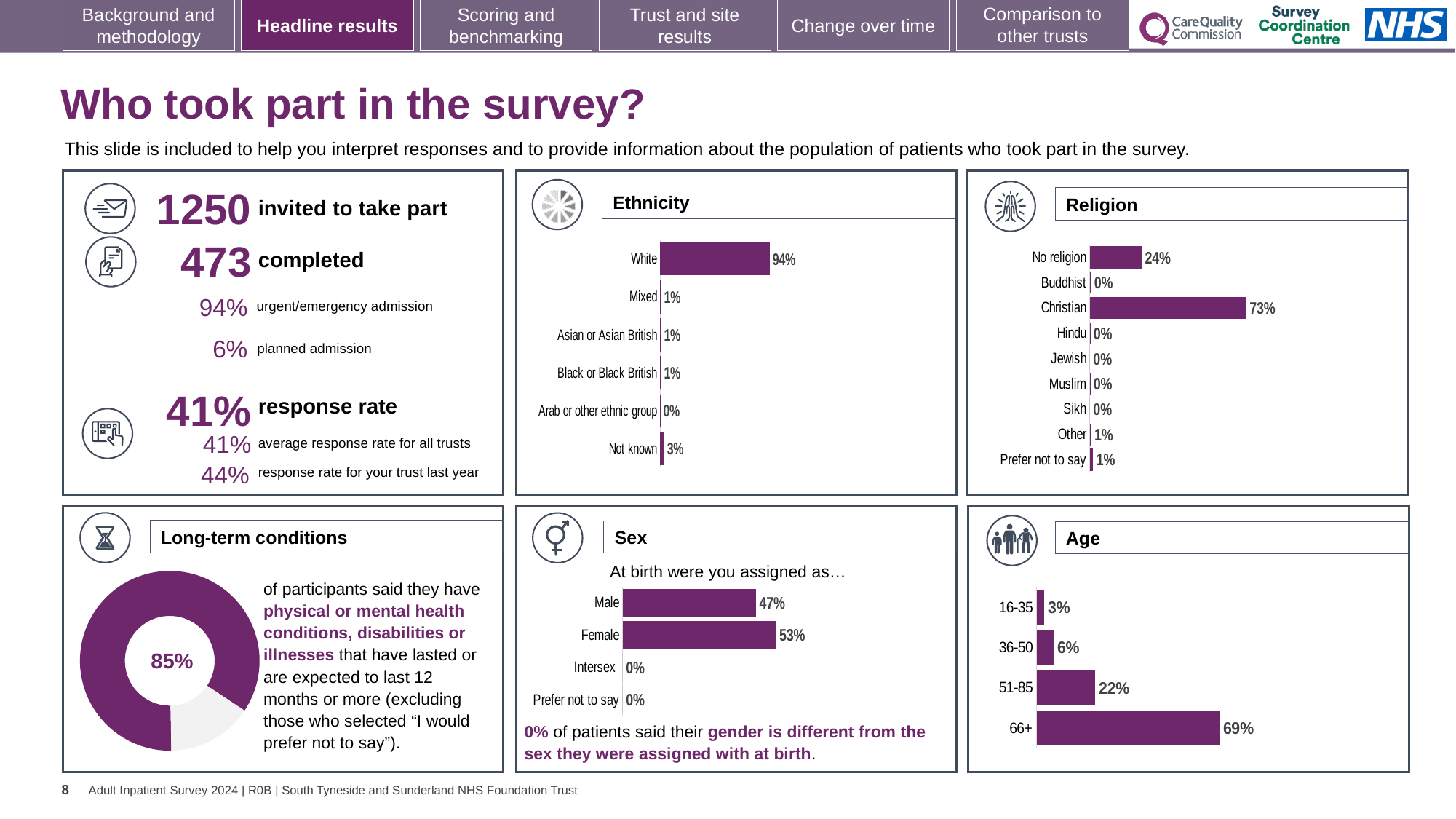
In the Ethnicity chart, which category has the highest value? White In the Age chart, what is the value for 51-85? 22% In the Age chart, what is the difference between 66+ and 36-50? 63% What kind of chart is used in the Long-term conditions panel? Doughnut chart In the Age chart, which age group has the highest value? 66+ In the Sex chart, which is larger, Male or Female? Female In the Religion chart, what is the difference between Christian and No religion? 49% In the Sex chart, what is the value for Male? 47% In the Ethnicity chart, what percentage of respondents are White? 94% How many categories are shown in the Religion chart? 9 In the Ethnicity chart, what is the value for Not known? 3% In the Religion chart, what percentage of respondents are Christian? 73%